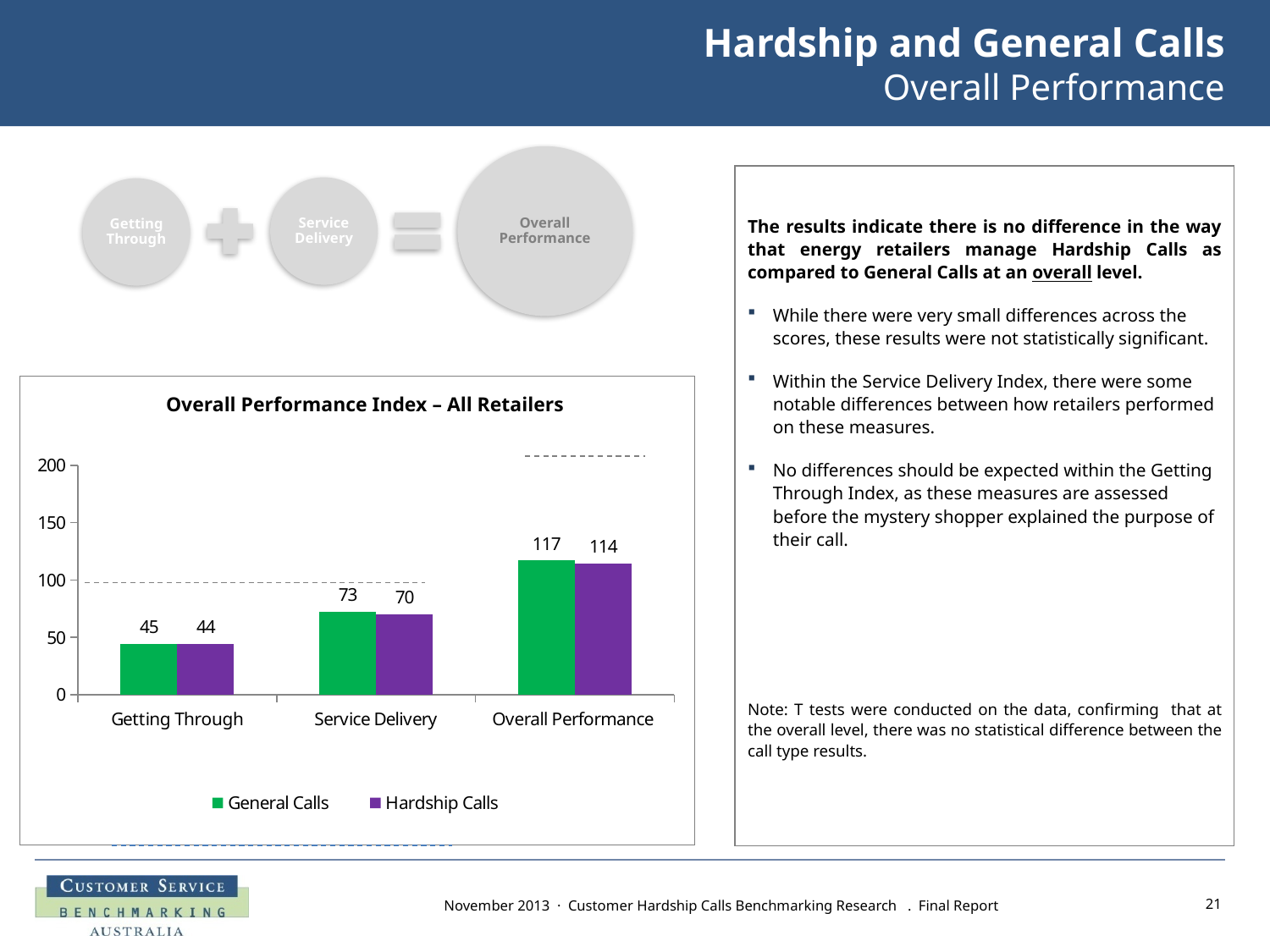
What kind of chart is shown on the slide? bar chart What is the value for Hardship Calls in the Overall Performance category? 114 What is the title of the chart? Overall Performance Index – All Retailers What is the difference between the General Calls values for Service Delivery and Getting Through? 28 Which category has the lowest value for Hardship Calls? Getting Through How many categories are shown on the x axis? 3 Is the value for General Calls in Overall Performance greater or less than 100? greater Which category has the highest value for General Calls? Overall Performance What is the difference between General Calls and Hardship Calls in the Overall Performance category? 3 What is the value for Hardship Calls in the Service Delivery category? 70 How many series does the legend list? 2 What is the value for General Calls in the Getting Through category? 45